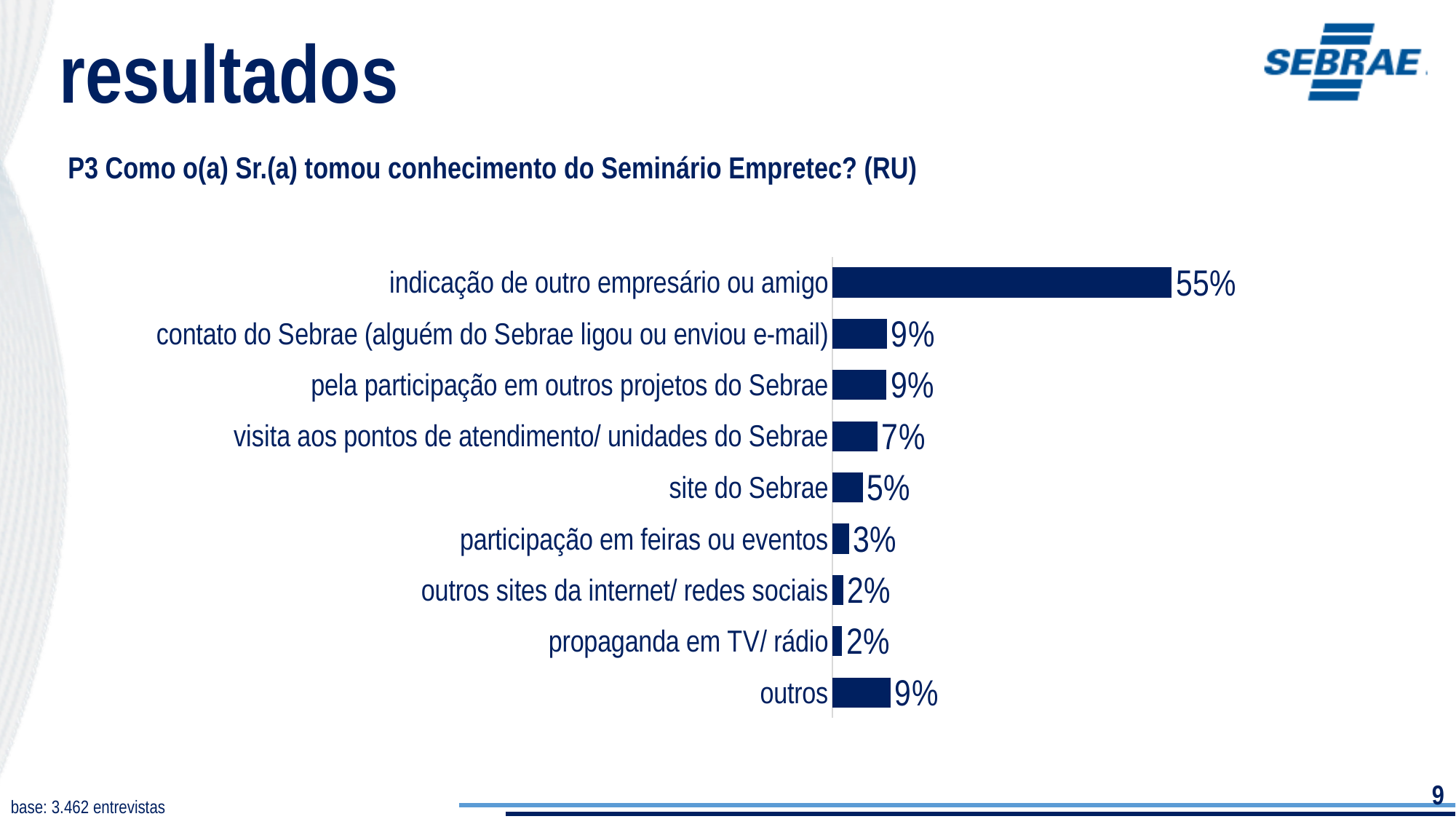
What is the value shown for 'visita aos pontos de atendimento/ unidades do Sebrae'? 7% What percentage of respondents learned about the Seminário Empretec through 'indicação de outro empresário ou amigo'? 55% What kind of chart is shown on the slide? bar chart What is the value shown for 'propaganda em TV/ rádio'? 2% What is the difference between the values for 'pela participação em outros projetos do Sebrae' and 'site do Sebrae'? 4% What is the value shown for 'participação em feiras ou eventos'? 3% Which is larger: the value for 'visita aos pontos de atendimento/ unidades do Sebrae' or the value for 'participação em feiras ou eventos'? visita aos pontos de atendimento/ unidades do Sebrae Which category has the highest value in the chart? indicação de outro empresário ou amigo How many categories are shown in the chart? 9 What is the base (number of interviews) stated on the slide? 3.462 entrevistas What is the value shown for 'site do Sebrae'? 5% What is the difference between the values for 'indicação de outro empresário ou amigo' and 'contato do Sebrae (alguém do Sebrae ligou ou enviou e-mail)'? 46%